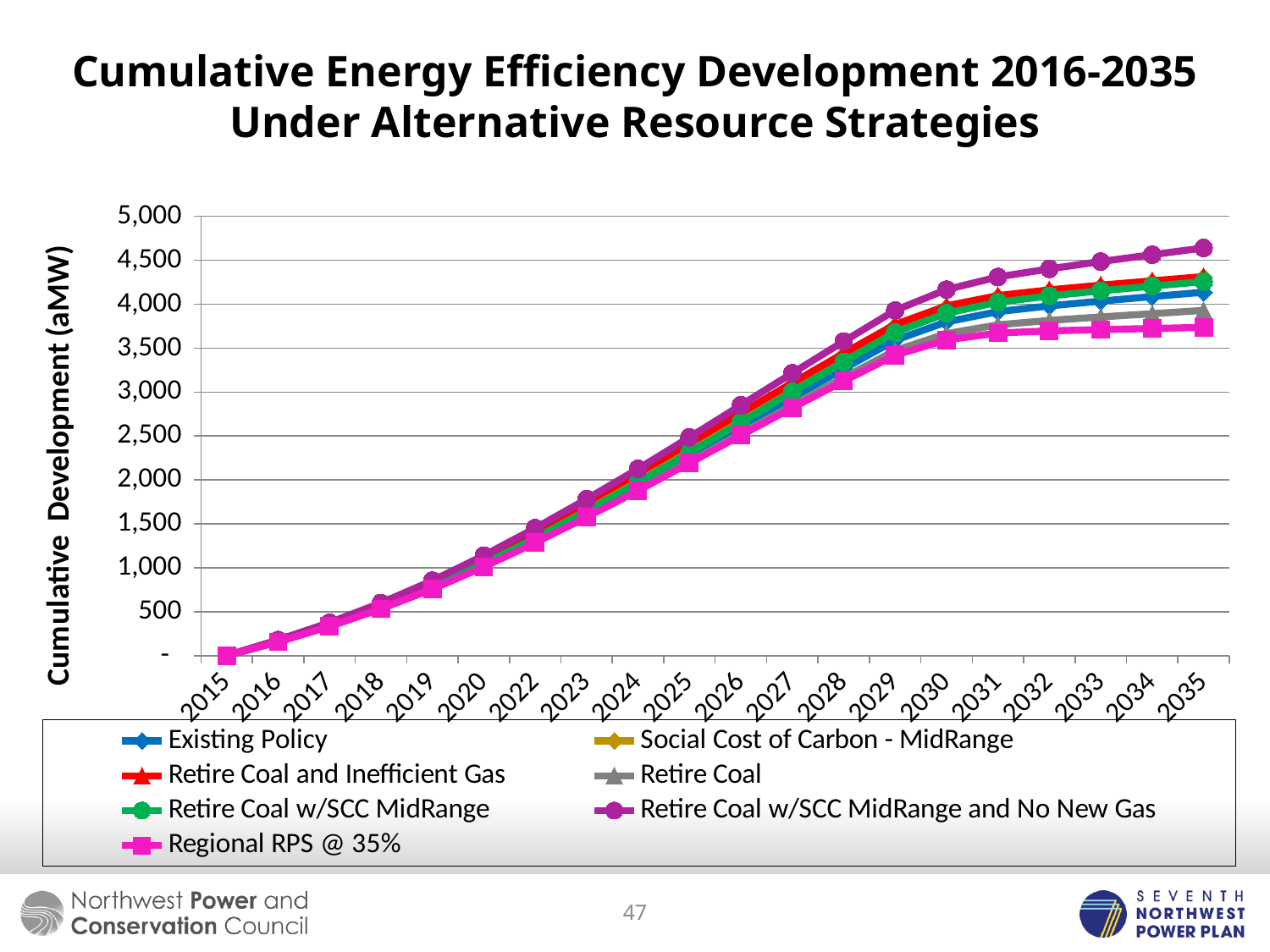
How many series does the legend list? 7 Is the 2035 value for Existing Policy greater or less than 4,000? greater What type of chart is shown on the slide? line chart Which series has the lowest cumulative development in 2035? Regional RPS @ 35% Is the 2035 value for Regional RPS @ 35% greater or less than 4,000? less In 2035, which is larger: Retire Coal w/SCC MidRange and No New Gas or Regional RPS @ 35%? Retire Coal w/SCC MidRange and No New Gas Is the 2019 value for Existing Policy greater or less than 1,000? less What is the title of the chart? Cumulative Energy Efficiency Development 2016-2035 Under Alternative Resource Strategies Do the values rise or fall from 2015 to 2035? rise What is the title of the vertical axis? Cumulative Development (aMW) Which series has the highest cumulative development in 2035? Retire Coal w/SCC MidRange and No New Gas